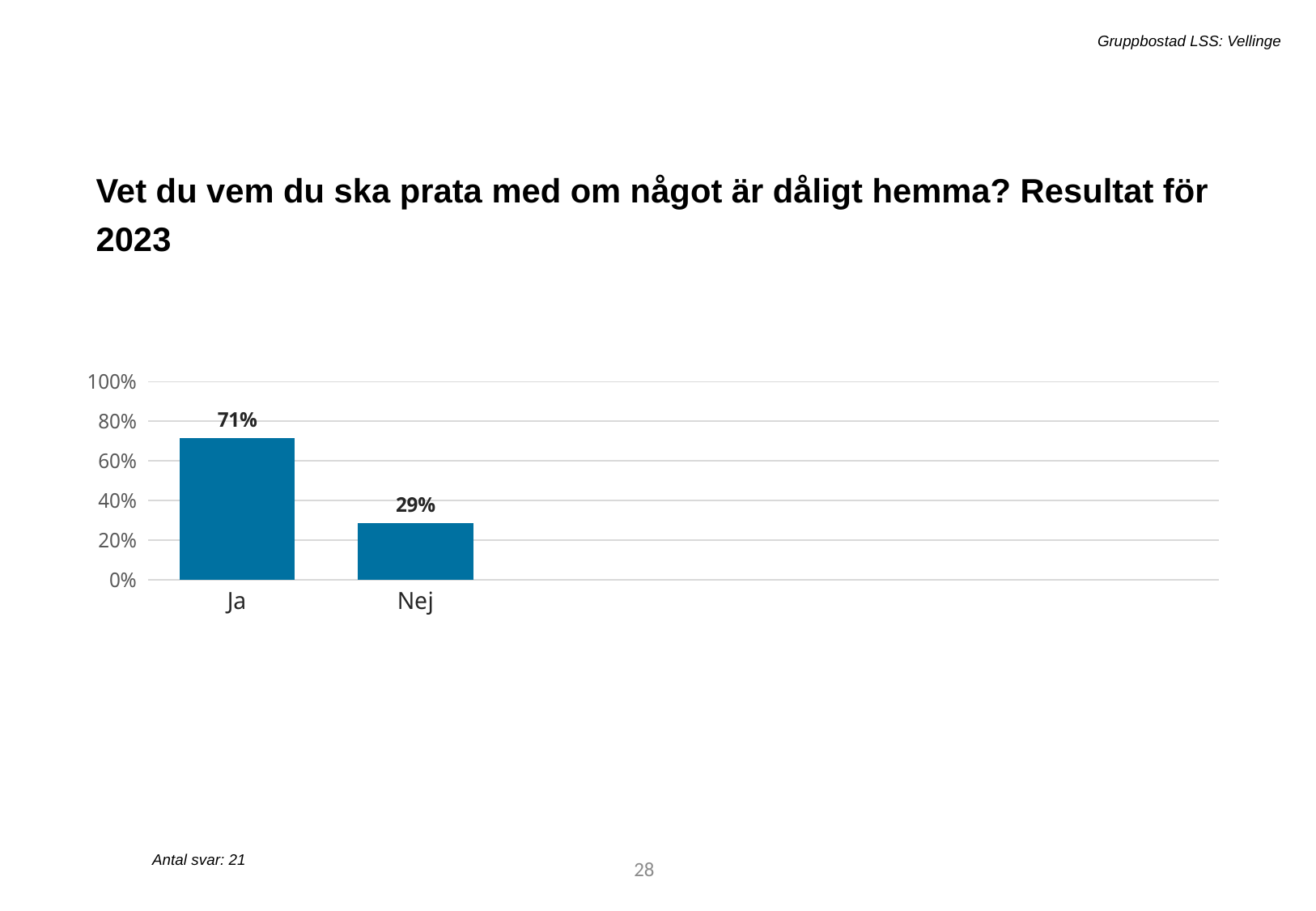
How many categories are shown on the x axis? 2 What is the value for Nej? 29% Is the value for Nej greater or less than 40%? less Which category has the highest value? Ja How many responses (Antal svar) does the slide report? 21 Is the value for Ja greater or less than 60%? greater What is the difference between the values for Ja and Nej? 42% Which category has the lowest value? Nej Which is larger, the value for Ja or the value for Nej? Ja What is the total of the values for Ja and Nej? 100% What is the value for Ja? 71% What kind of chart is shown on the slide? bar chart